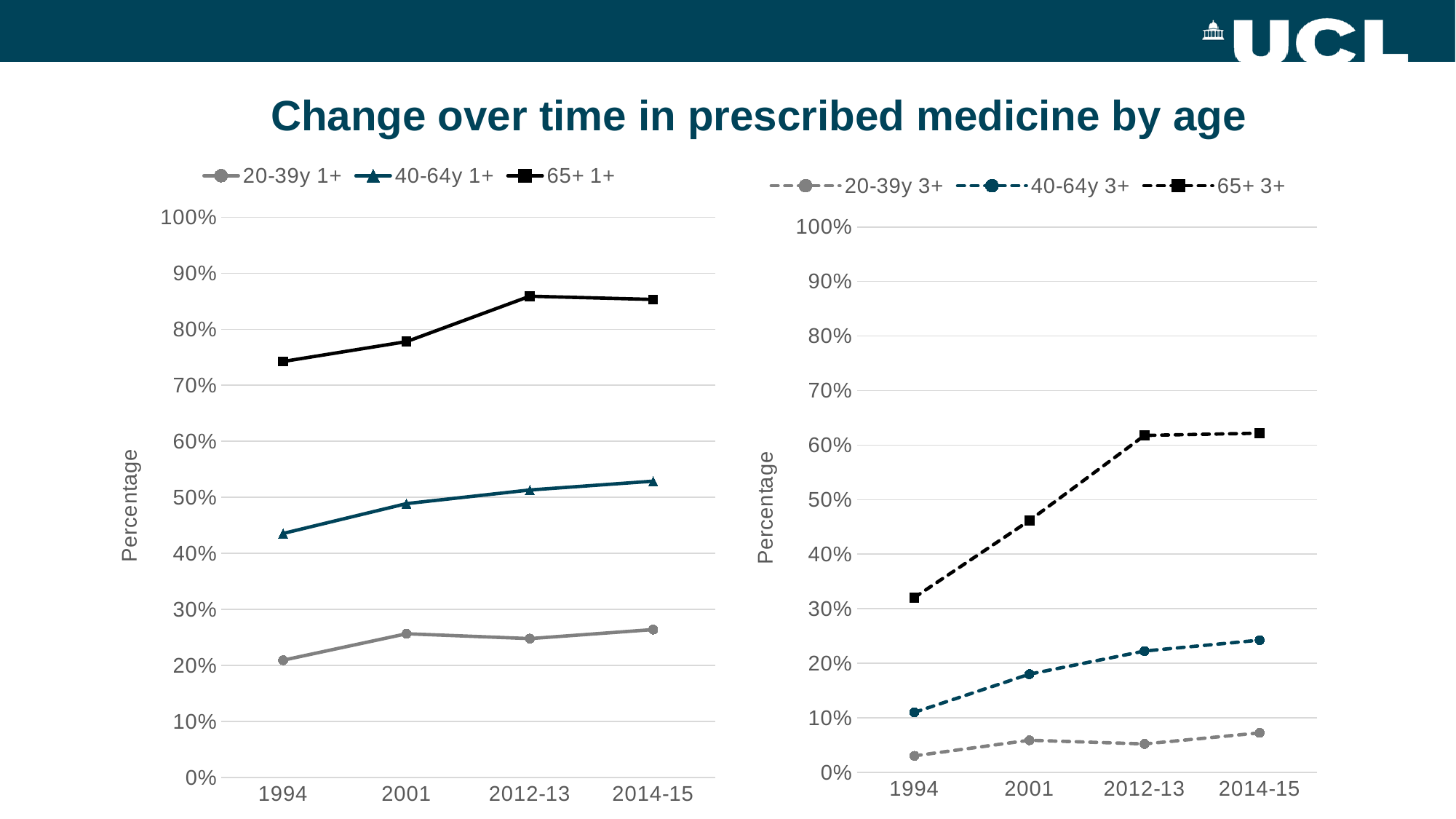
In the right chart, is the value for 40-64y 3+ in 1994 greater or less than 20%? less How many series does the legend of the left chart list? 3 In the left chart, is the value for 40-64y 1+ in 2014-15 greater or less than 50%? greater In the right chart, which is larger in 2014-15: 40-64y 3+ or 20-39y 3+? 40-64y 3+ How many series does the legend of the right chart list? 3 In the left chart, is the value for 65+ 1+ in 1994 greater or less than 70%? greater What is the y-axis label on the left chart? Percentage What kind of chart is the left chart on the slide? line chart In the right chart, does the 65+ 3+ series rise or fall from 1994 to 2012-13? rise In the left chart, which series has the highest value in 2014-15? 65+ 1+ How many time points are shown on the x axis of the right chart? 4